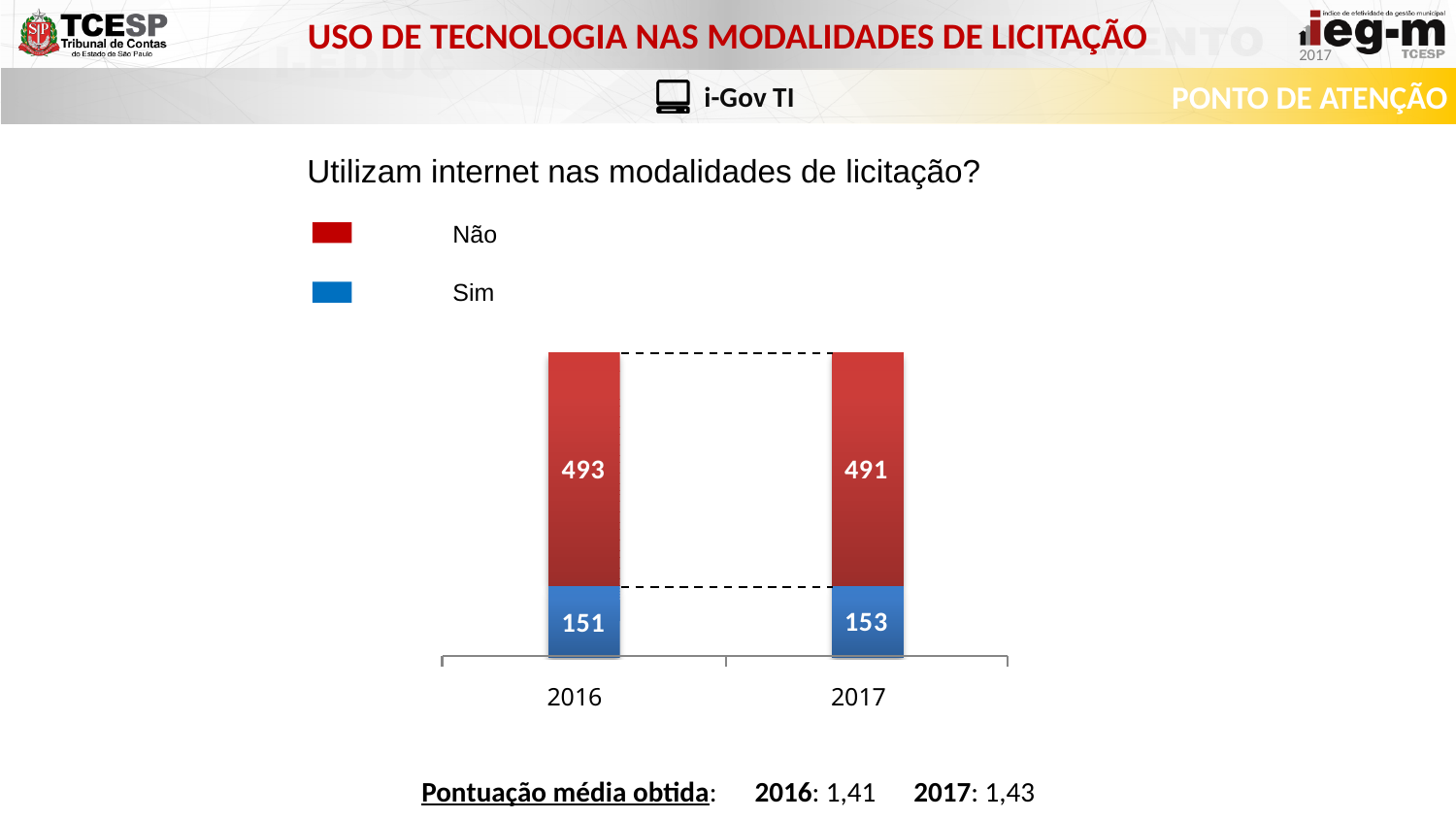
What is the value for "Não" in 2017? 491 What kind of chart is shown on the slide? stacked bar chart Which is larger in 2016, the "Não" value or the "Sim" value? Não What is the value for "Sim" in 2016? 151 Which colour represents "Sim" in the chart? blue What is the value for "Não" in 2016? 493 Does the "Sim" value rise or fall from 2016 to 2017? rise What is the difference between the "Não" values for 2016 and 2017? 2 How many years are shown on the x axis of the chart? 2 What is the value for "Sim" in 2017? 153 What is the total of the stacked bar for 2017? 644 How many series does the legend list? 2